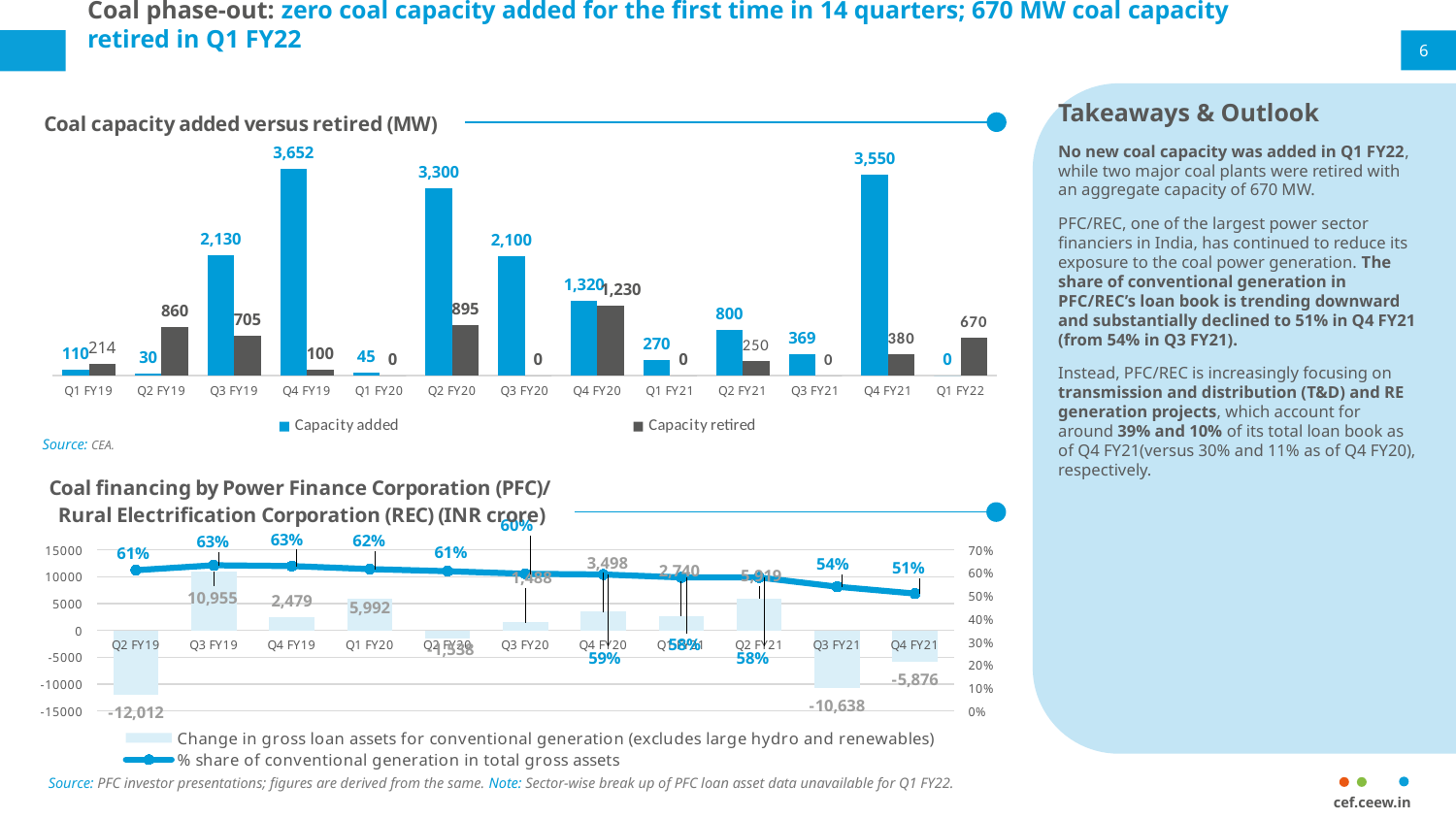
In the 'Coal capacity added versus retired (MW)' chart, which quarter has the highest capacity added? Q4 FY19 In the 'Coal capacity added versus retired (MW)' chart, what is the capacity added in Q4 FY19? 3,652 How many quarters are shown on the x axis of the 'Coal capacity added versus retired (MW)' chart? 13 What type of chart is the 'Coal capacity added versus retired (MW)' chart? Bar chart In the 'Coal capacity added versus retired (MW)' chart, which quarter has the highest capacity retired? Q4 FY20 In the 'Coal financing by PFC/REC' chart, what is the % share of conventional generation in total gross assets in Q4 FY21? 51% In the 'Coal financing by PFC/REC' chart, what is the change in gross loan assets for conventional generation in Q2 FY19? -12,012 In the 'Coal capacity added versus retired (MW)' chart, what is the difference between capacity added and capacity retired in Q2 FY20? 2,405 In the 'Coal financing by PFC/REC' chart, does the % share of conventional generation line rise or fall from Q1 FY20 to Q4 FY21? Fall In the 'Coal capacity added versus retired (MW)' chart, which is larger in Q2 FY19: capacity added or capacity retired? Capacity retired How many series does the legend of the 'Coal capacity added versus retired (MW)' chart list? 2 In the 'Coal capacity added versus retired (MW)' chart, what is the capacity retired in Q1 FY22? 670